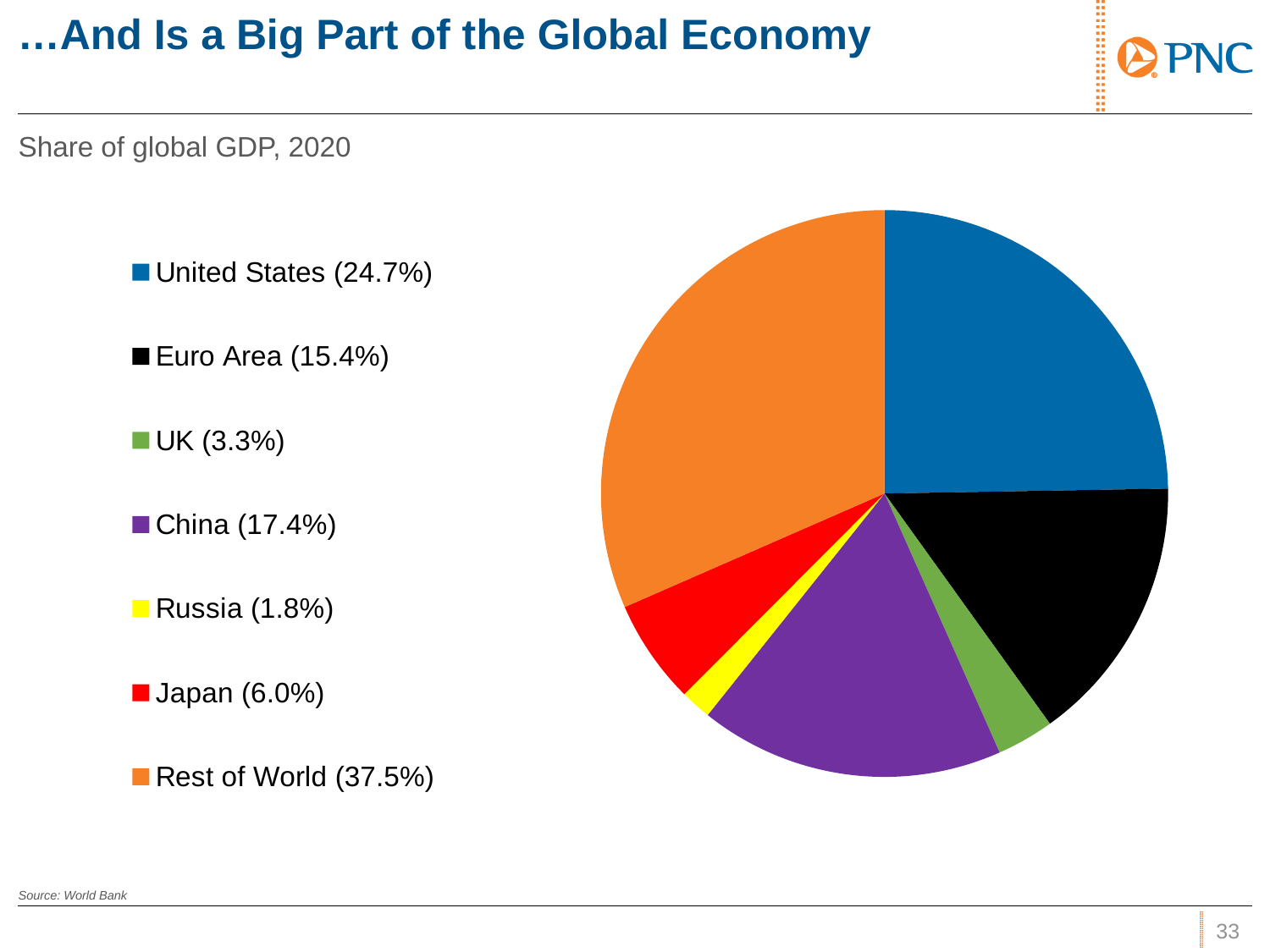
What is the difference in share of global GDP between Japan and the UK? 2.7% Which has a larger share of global GDP, the Euro Area or China? China What share of global GDP does Russia have? 1.8% What share of global GDP does the United States have? 24.7% Which category has the smallest share of global GDP? Russia What share of global GDP does China have? 17.4% What kind of chart is shown on the slide? pie chart How many categories does the pie chart show? 7 What is the subtitle of the chart? Share of global GDP, 2020 Which category has the largest share of global GDP? Rest of World What is the difference in share of global GDP between the United States and the Euro Area? 9.3% What colour is the slice for Japan? red